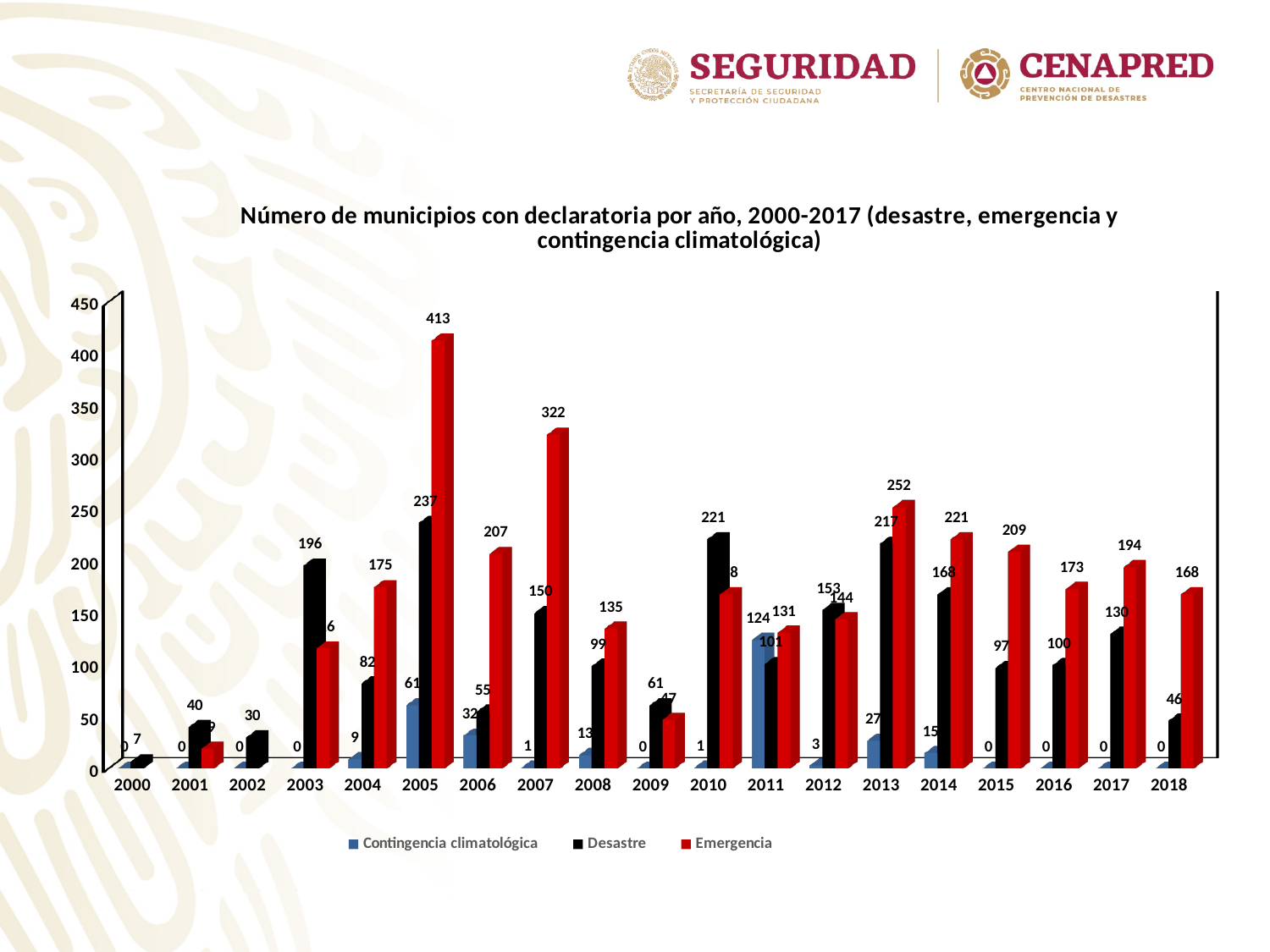
What is the Contingencia climatológica value for 2011? 124 What is the difference between the Emergencia and Desastre values in 2013? 35 In which year is the Contingencia climatológica value highest? 2011 How many series does the legend list? 3 What is the Emergencia value for 2005? 413 What kind of chart is shown on the slide? Bar chart What is the difference between the Emergencia and Desastre values in 2005? 176 How many years are shown on the x axis? 19 What is the Emergencia value for 2018? 168 What is the Desastre value for 2007? 150 In which year is the Emergencia value highest? 2005 In 2012, which is larger: Desastre or Emergencia? Desastre